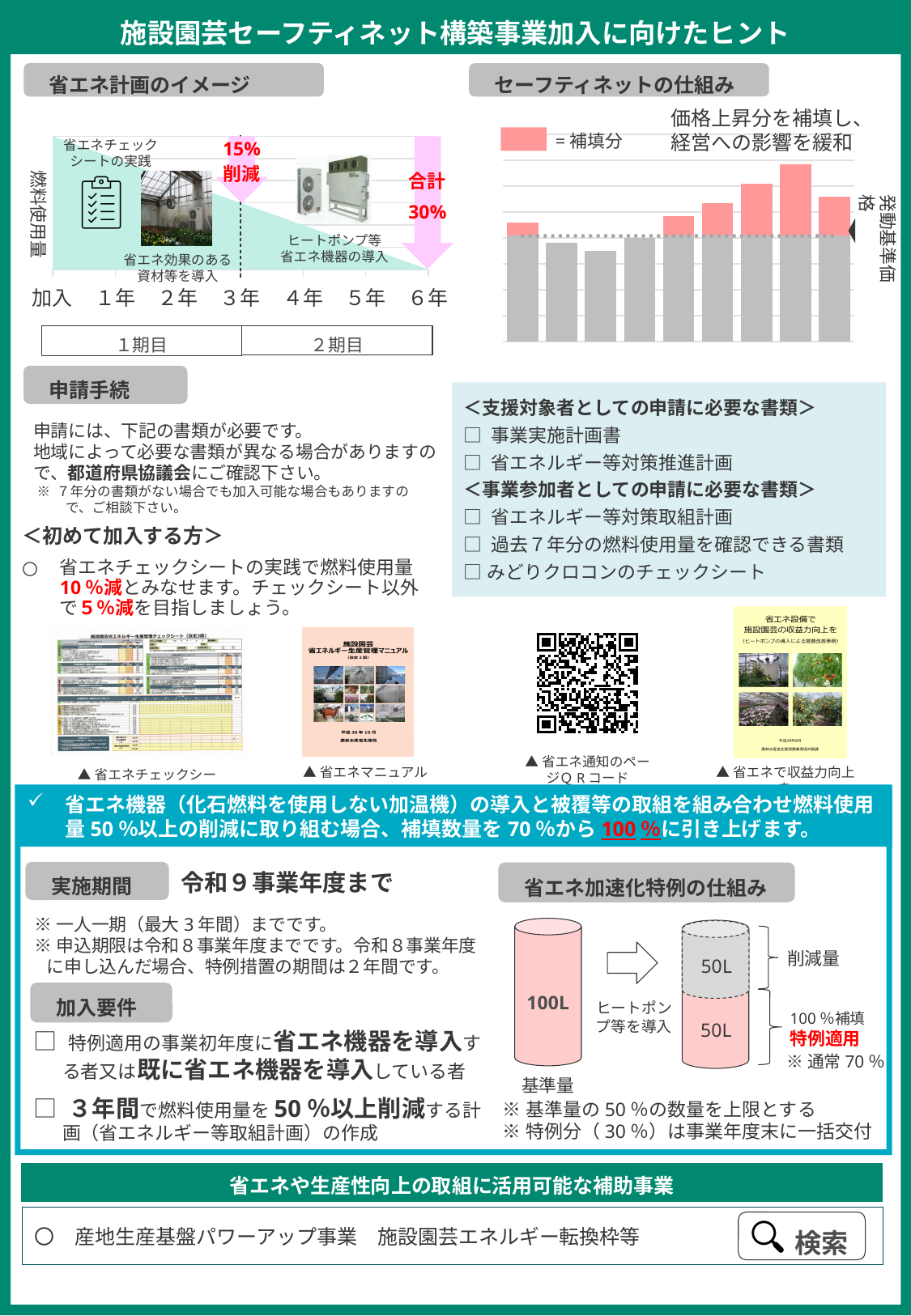
What kind of chart is shown under the heading セーフティネットの仕組み? bar chart In the セーフティネットの仕組み bar chart, which bar (counting from the left) is the shortest? the 3rd bar In the 省エネ計画のイメージ chart, what reduction is labelled at the 3年 point? 15%削減 In the 省エネ計画のイメージ chart, how many time points are labelled on the horizontal axis (from 加入 to 6年)? 7 In the セーフティネットの仕組み bar chart, how many bars have a pink 補填分 portion above the dotted 発動基準価格 line? 6 In the 省エネ加速化特例の仕組み diagram, what is the 基準量 shown on the left cylinder? 100L In the セーフティネットの仕組み bar chart, which bar (counting from the left) is the tallest? the 8th bar In the 省エネ計画のイメージ chart, what is the label on the vertical axis? 燃料使用量 In the セーフティネットの仕組み bar chart, what does the pink colour represent according to the legend? 補填分 In the 省エネ計画のイメージ chart, what total reduction is labelled at 6年? 合計30% In the セーフティネットの仕組み bar chart, how many bars are plotted? 9 In the 省エネ計画のイメージ chart, does fuel usage rise or fall from 加入 to 6年? fall